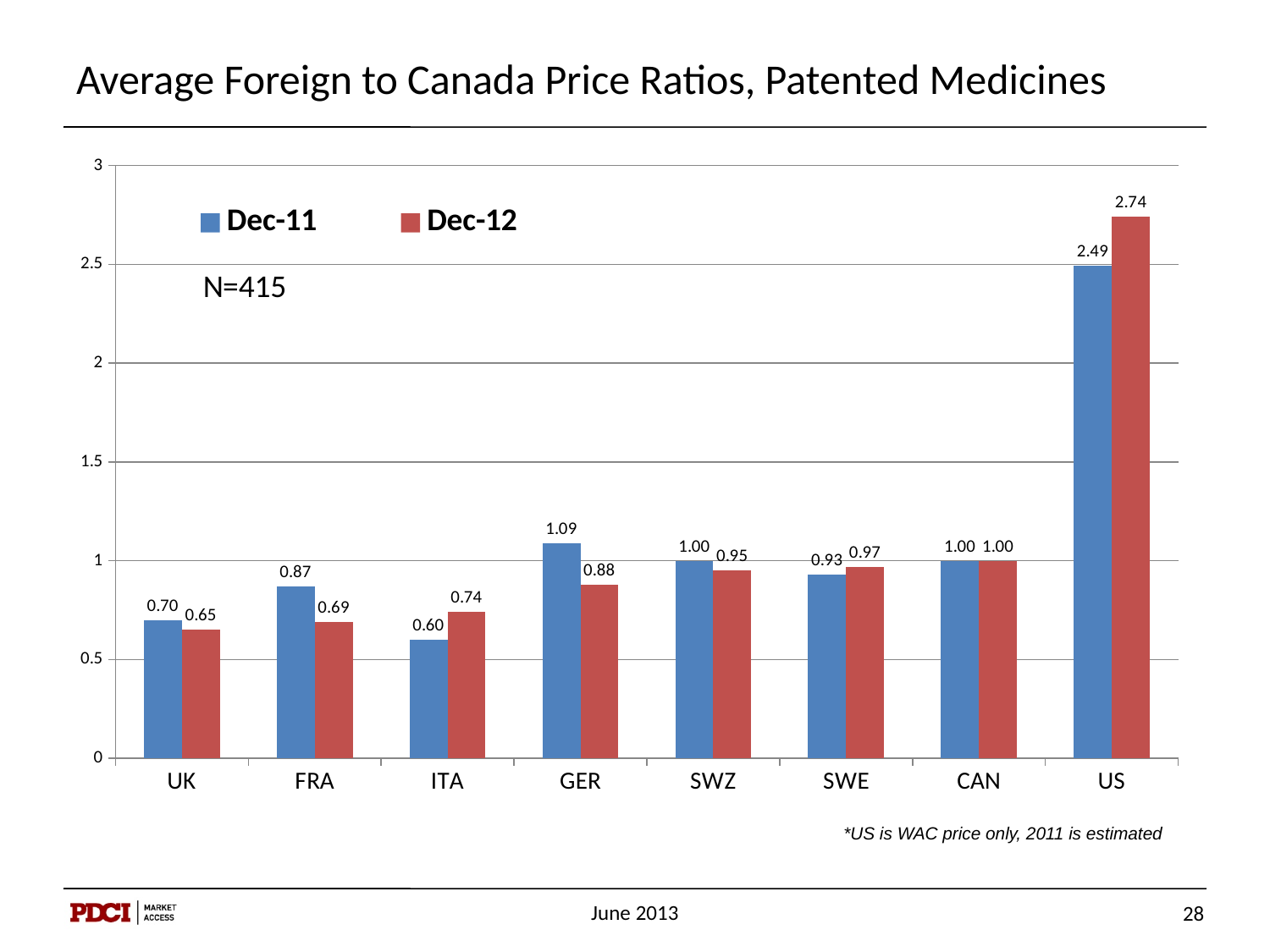
Which country has the highest Dec-11 value? US How many countries are shown on the x axis? 8 Which is larger for FRA, the Dec-11 value or the Dec-12 value? Dec-11 What is the title of the chart? Average Foreign to Canada Price Ratios, Patented Medicines What is the difference between the Dec-12 and Dec-11 values for US? 0.25 How many series does the legend list? 2 Which country has the lowest Dec-12 value? UK Is the Dec-11 value for GER greater or less than 1? greater What is the Dec-12 value for GER? 0.88 What kind of chart is shown on the slide? Bar chart What is the Dec-12 value for US? 2.74 What is the Dec-11 value for ITA? 0.60